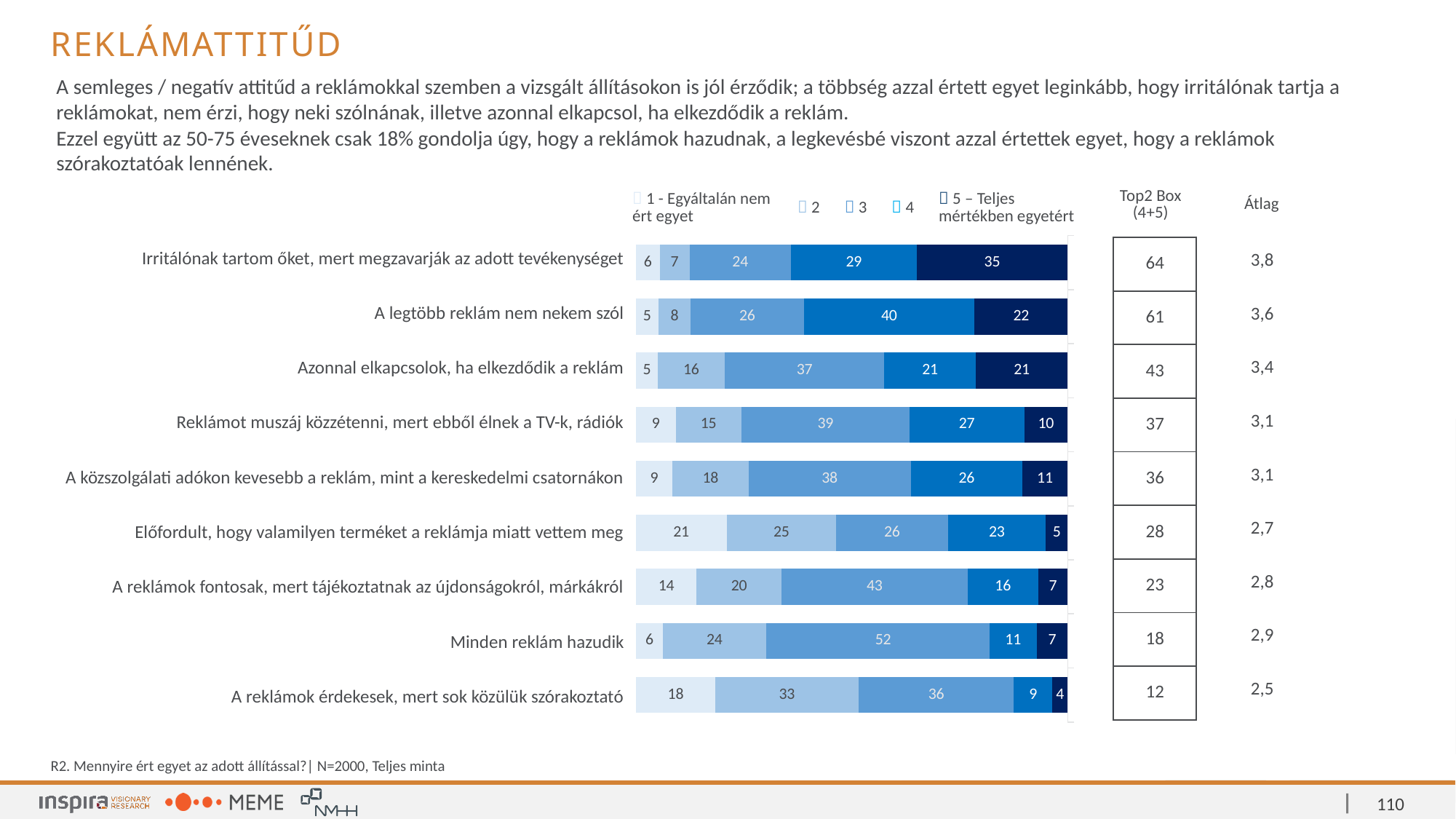
What kind of chart is shown on the slide? Stacked bar chart How many series does the legend list? 5 What is the difference between the '4' series values for 'A legtöbb reklám nem nekem szól' and 'Azonnal elkapcsolok, ha elkezdődik a reklám'? 19 Which statement has the highest value for the '5 – Teljes mértékben egyetért' series? Irritálónak tartom őket, mert megzavarják az adott tevékenységet What is the Top2 Box (4+5) value shown for 'Minden reklám hazudik'? 18 What is the value of the '3' series for 'Minden reklám hazudik'? 52 How many statements (categories) are shown in the chart? 9 Which has the larger '1 - Egyáltalán nem ért egyet' value: 'Előfordult, hogy valamilyen terméket a reklámja miatt vettem meg' or 'A reklámok érdekesek, mert sok közülük szórakoztató'? Előfordult, hogy valamilyen terméket a reklámja miatt vettem meg Which statement has the lowest value for the '5 – Teljes mértékben egyetért' series? A reklámok érdekesek, mert sok közülük szórakoztató What is the value of the '2' series for 'A reklámok fontosak, mert tájékoztatnak az újdonságokról, márkákról'? 20 What is the total of the stacked bar for 'Minden reklám hazudik'? 100 What is the value of the '5 – Teljes mértékben egyetért' series for 'Irritálónak tartom őket, mert megzavarják az adott tevékenységet'? 35